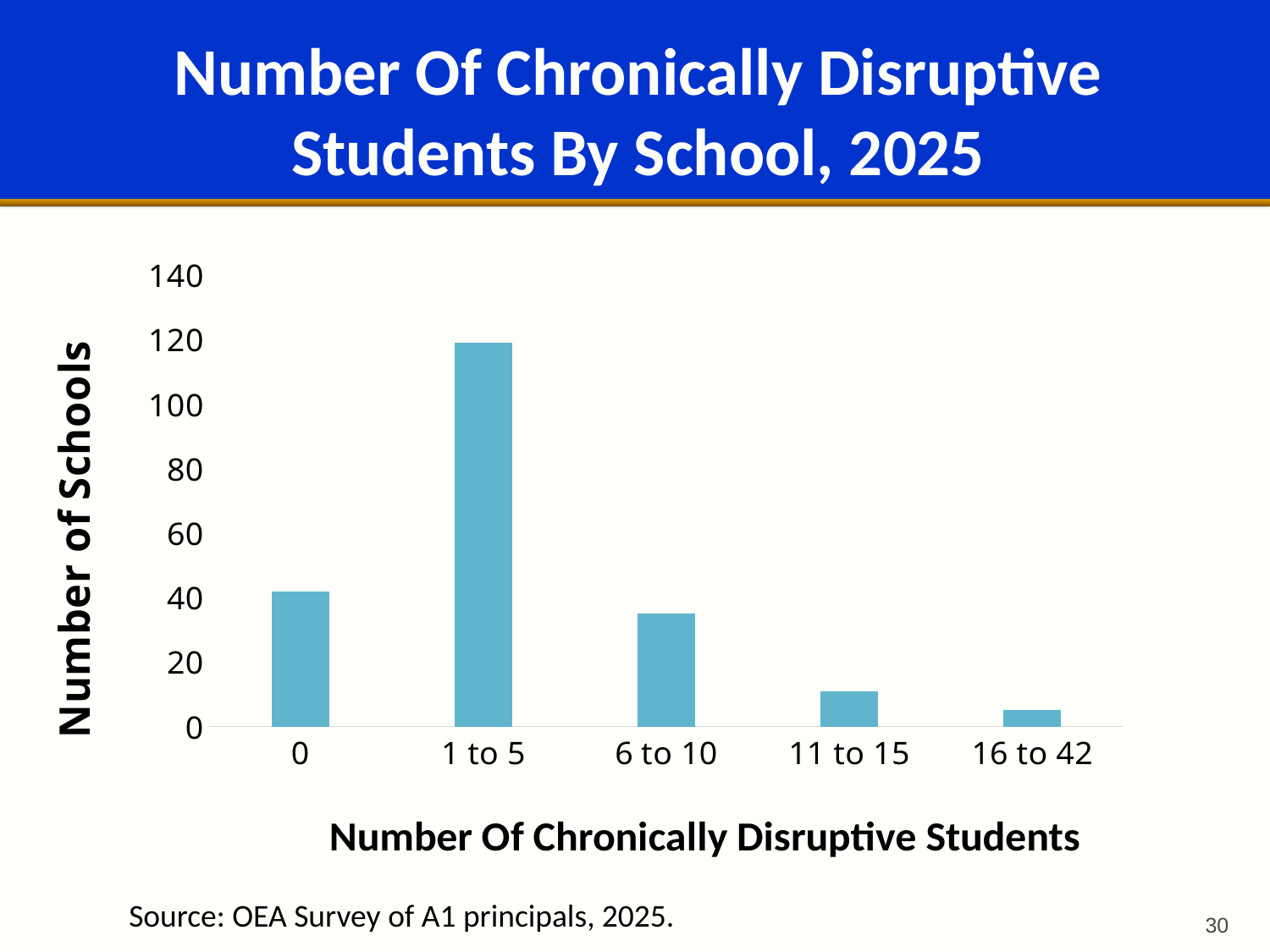
Which category has the highest number of schools? 1 to 5 Which category has the lowest number of schools? 16 to 42 Is the number of schools for the '11 to 15' category greater or less than 20? less What kind of chart is shown on the slide? bar chart Is the number of schools for the '16 to 42' category greater or less than 20? less Is the number of schools for the '1 to 5' category greater or less than 100? greater How many categories are shown on the x axis of the chart? 5 Which category has more schools, '11 to 15' or '16 to 42'? 11 to 15 What is the label of the vertical axis of the chart? Number of Schools Which category has more schools, '1 to 5' or '0'? 1 to 5